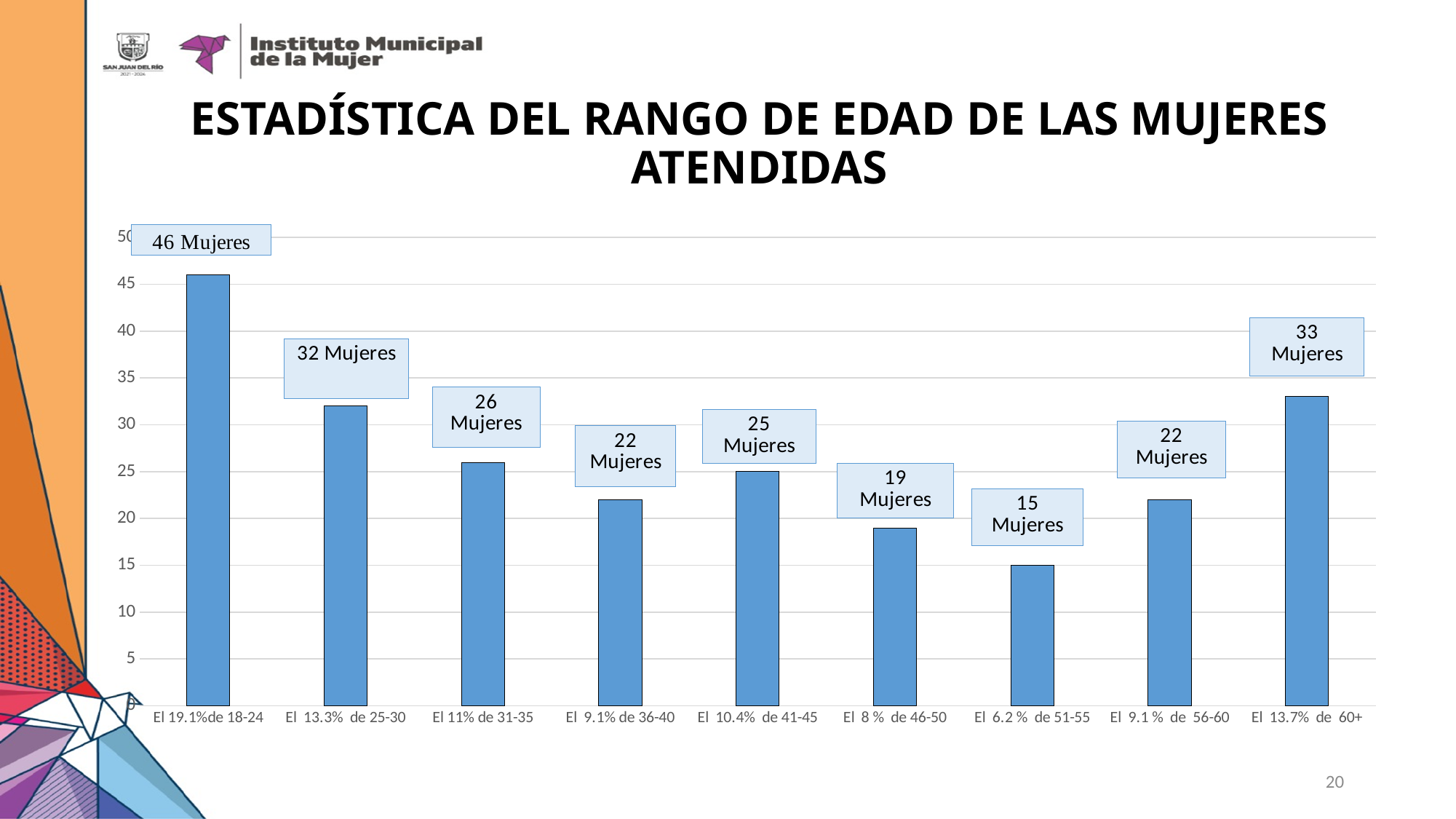
What kind of chart is shown on the slide? Bar chart How many women are shown for the 60+ age range? 33 Mujeres Which has more women attended, the 41-45 range or the 46-50 range? 41-45 Which age range has the highest number of women attended? 18-24 How many women are shown for the 51-55 age range? 15 Mujeres What percentage is shown for the 31-35 age range in the category label? 11% Which age range has the lowest number of women attended? 51-55 What is the title of the slide? ESTADÍSTICA DEL RANGO DE EDAD DE LAS MUJERES ATENDIDAS What is the difference between the number of women in the 60+ range and the 56-60 range? 11 How many women (Mujeres) are shown for the 18-24 age range? 46 Mujeres How many age-range categories are plotted in the chart? 9 What is the difference between the number of women in the 18-24 range and the 25-30 range? 14